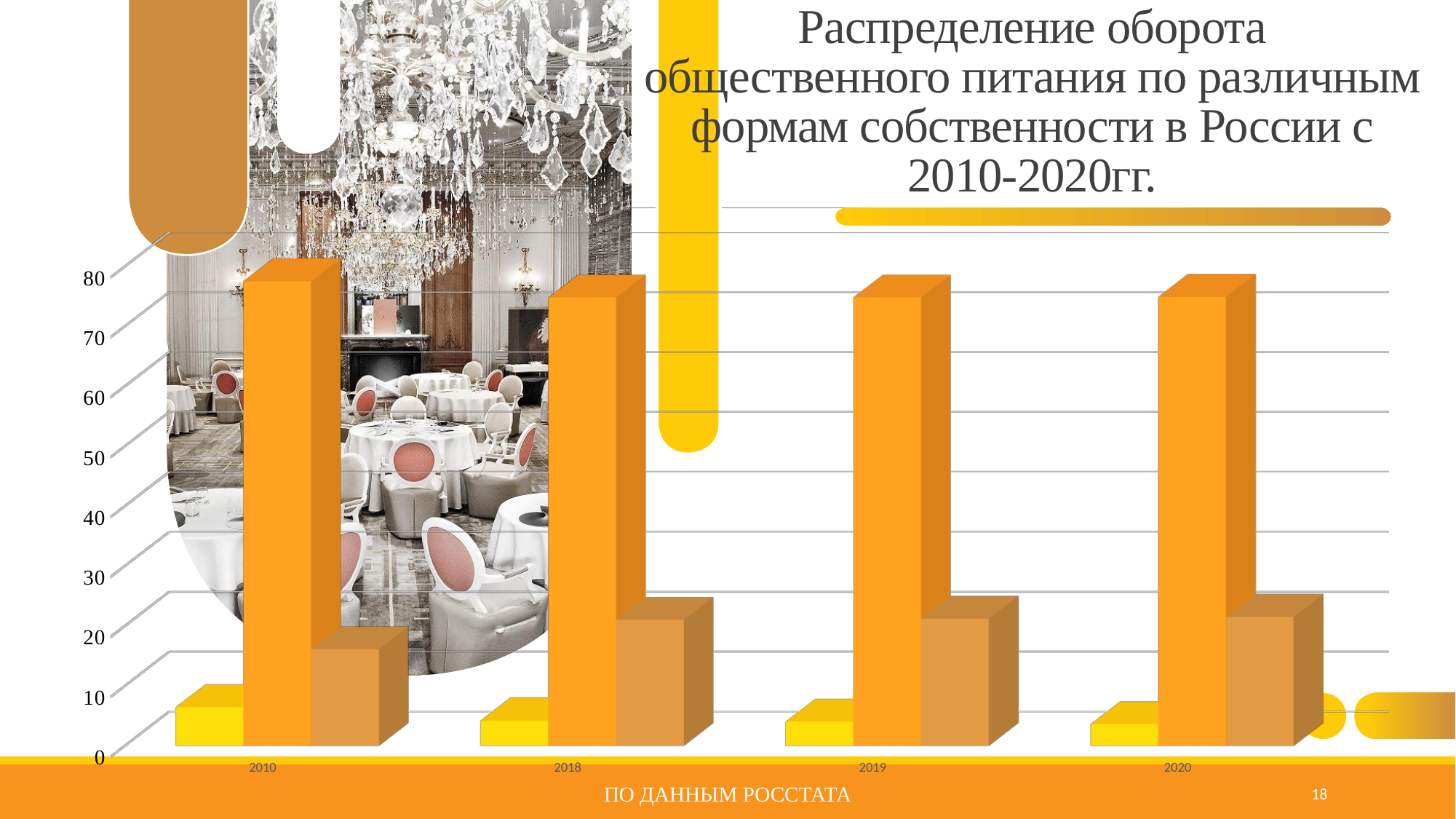
Which is larger: the tallest bar for 2010 or the tallest bar for 2019? 2010 Is the value of the tallest bar for 2020 greater or less than 70? greater In which year is the middle-height (brown) bar the lowest? 2010 What kind of chart is shown on the slide? bar chart Does the tallest bar rise or fall from 2010 to 2020? fall What is the highest value shown on the vertical axis of the chart? 80 Is the value of the tallest bar for 2010 greater or less than 70? greater In which year is the tallest (orange) bar the highest? 2010 Is the value of the middle-height (brown) bar for 2010 greater or less than 20? less What is the title of the chart on the slide? Распределение оборота общественного питания по различным формам собственности в России с 2010-2020гг. How many years are shown on the x axis of the chart? 4